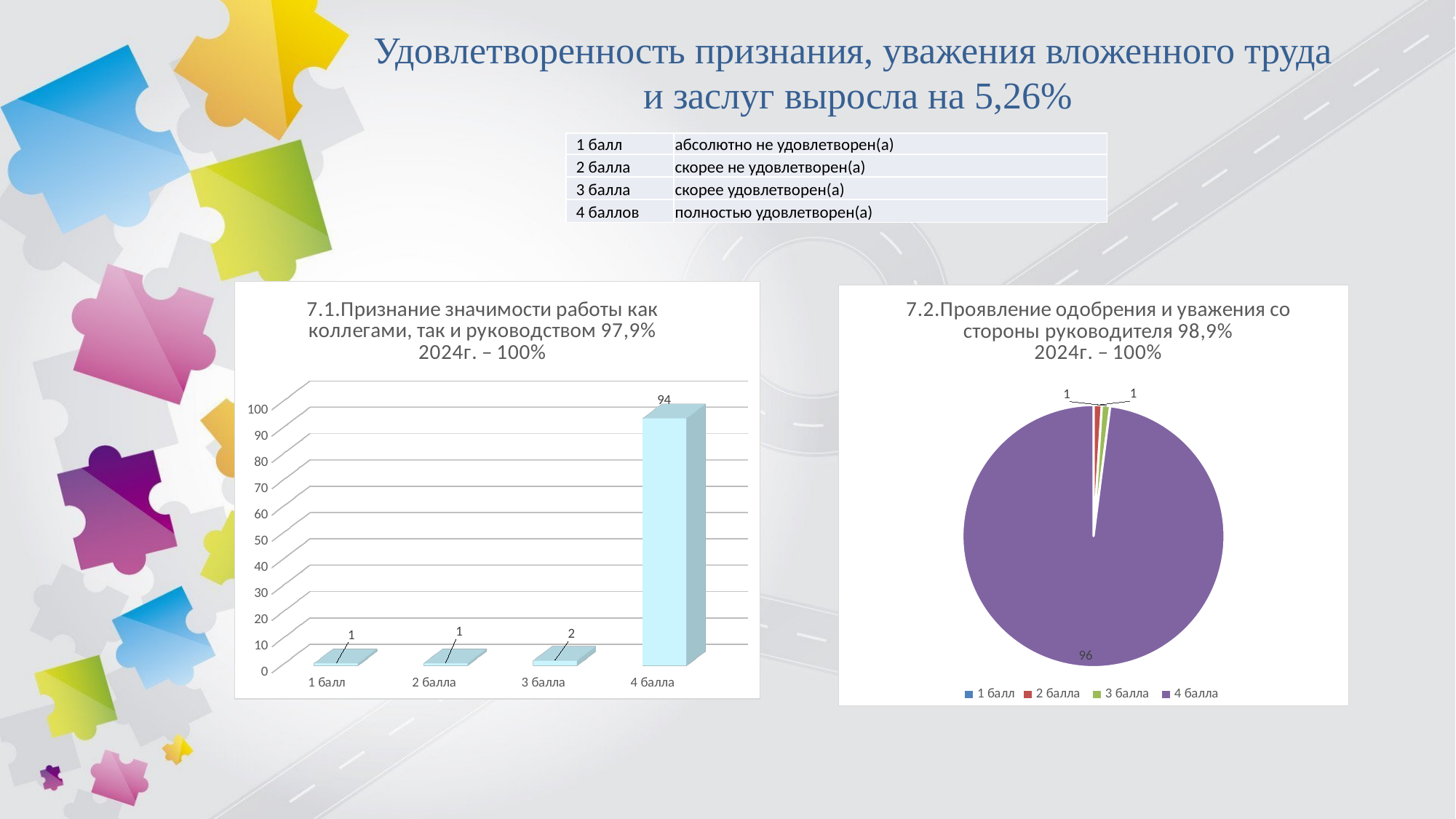
In the chart titled 7.2, what is the value labelled on the 4 балла slice? 96 In the chart titled 7.1, what is the value for 1 балл? 1 In the chart titled 7.1, which category has the highest value? 4 балла In the chart titled 7.1, is the value for 4 балла greater or less than 90? greater In the chart titled 7.1, what is the value for 3 балла? 2 In the chart titled 7.1, which is larger: the value for 3 балла or the value for 2 балла? 3 балла In the chart titled 7.1, what is the difference between the values for 4 балла and 3 балла? 92 In the chart titled 7.1, what is the value for 4 балла? 94 How many entries does the legend of the chart titled 7.2 list? 4 What kind of chart is the chart titled 7.1? bar chart In the chart titled 7.1, how many categories are shown on the x axis? 4 What kind of chart is the chart titled 7.2? pie chart